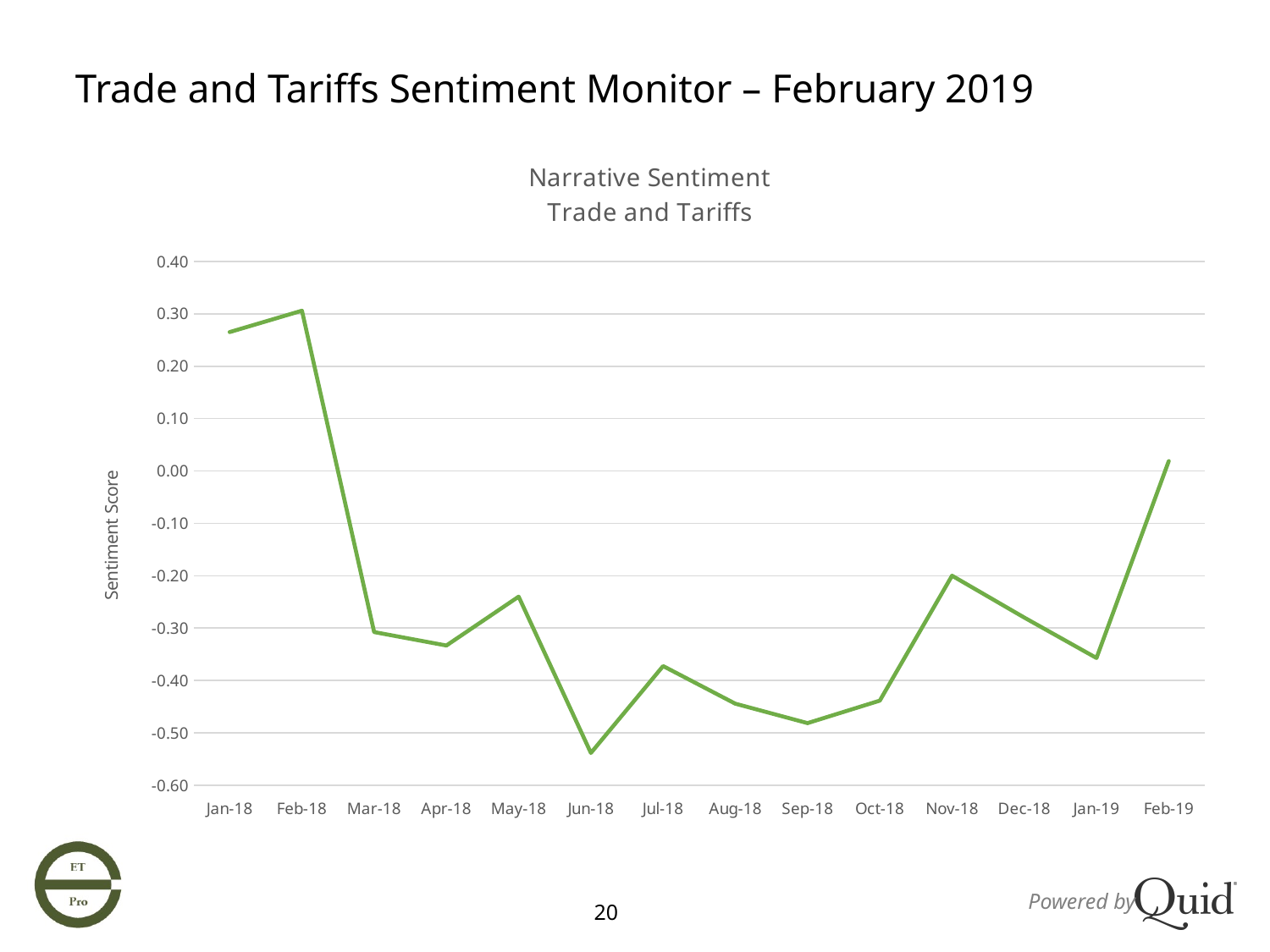
Is the sentiment score for Jun-18 greater or less than -0.50? less Is the sentiment score for Jan-18 greater or less than 0.20? greater Is the sentiment score for Sep-18 greater or less than -0.40? less Which month has the highest sentiment score? Feb-18 What is the title of the chart? Narrative Sentiment Trade and Tariffs Which month has the lowest sentiment score? Jun-18 What is the label of the vertical axis? Sentiment Score Does the sentiment score rise or fall from Jan-19 to Feb-19? rise Which month has the higher sentiment score, Nov-18 or Sep-18? Nov-18 How many months are plotted on the x axis? 14 What kind of chart is shown on the slide? line chart